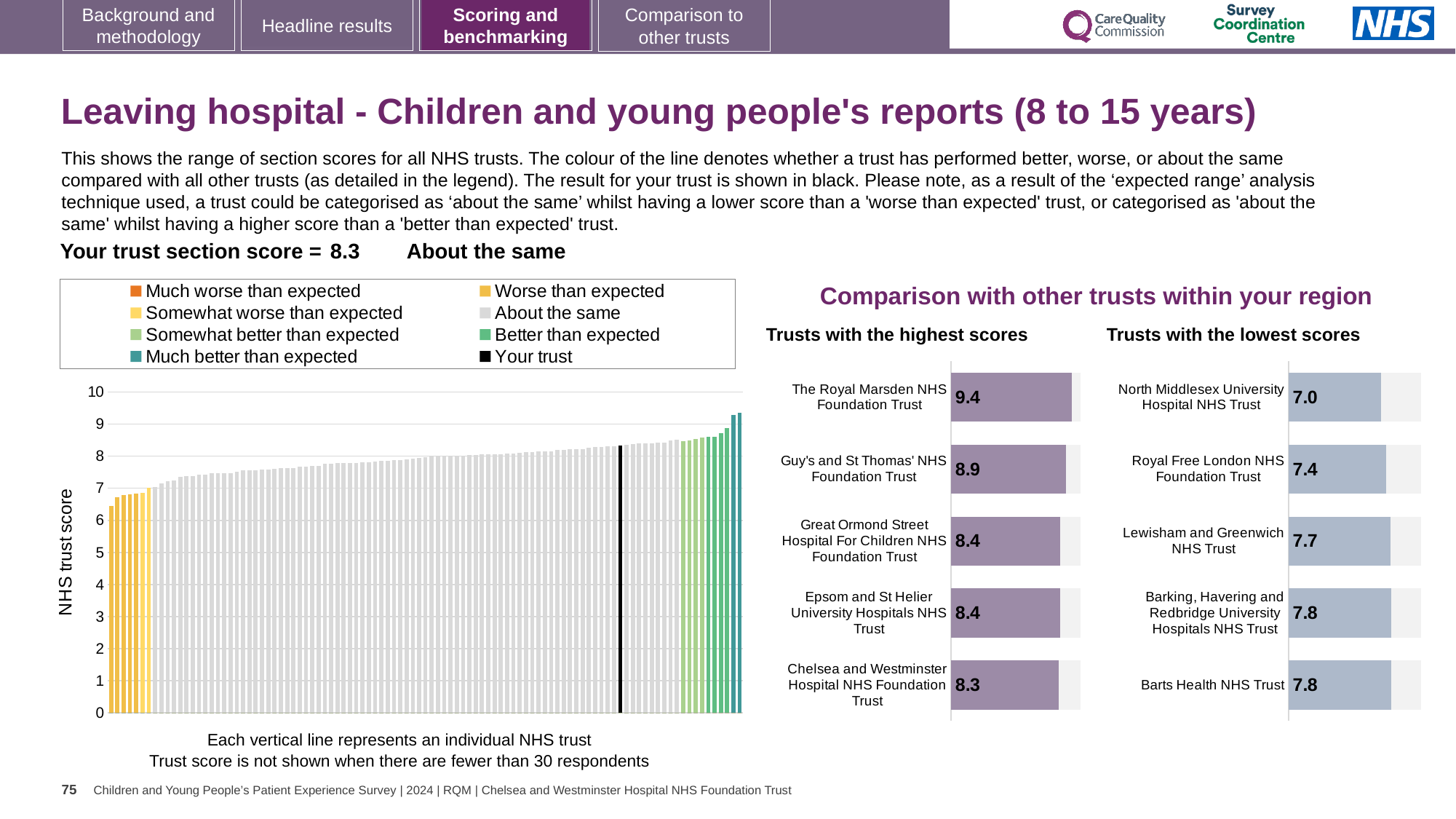
In the large chart on the left showing all NHS trusts, how many entries does the legend list? 8 In the 'Trusts with the highest scores' chart, how many trusts are shown? 5 In the 'Trusts with the highest scores' chart, what is the score for Guy's and St Thomas' NHS Foundation Trust? 8.9 In the 'Trusts with the lowest scores' chart, which has the larger score: Royal Free London NHS Foundation Trust or Barts Health NHS Trust? Barts Health NHS Trust In the 'Trusts with the highest scores' chart, which trust has the highest score? The Royal Marsden NHS Foundation Trust In the large chart on the left showing all NHS trusts, what kind of chart is it? Bar chart In the 'Trusts with the highest scores' chart, what is the score for The Royal Marsden NHS Foundation Trust? 9.4 In the 'Trusts with the lowest scores' chart, what is the score for North Middlesex University Hospital NHS Trust? 7.0 In the 'Trusts with the lowest scores' chart, what is the difference between the scores of Lewisham and Greenwich NHS Trust and North Middlesex University Hospital NHS Trust? 0.7 In the 'Trusts with the highest scores' chart, what is the difference between the scores of The Royal Marsden NHS Foundation Trust and Guy's and St Thomas' NHS Foundation Trust? 0.5 In the large chart on the left showing all NHS trusts, is the value for the black 'Your trust' bar greater or less than 8? greater In the 'Trusts with the lowest scores' chart, which trust has the lowest score? North Middlesex University Hospital NHS Trust